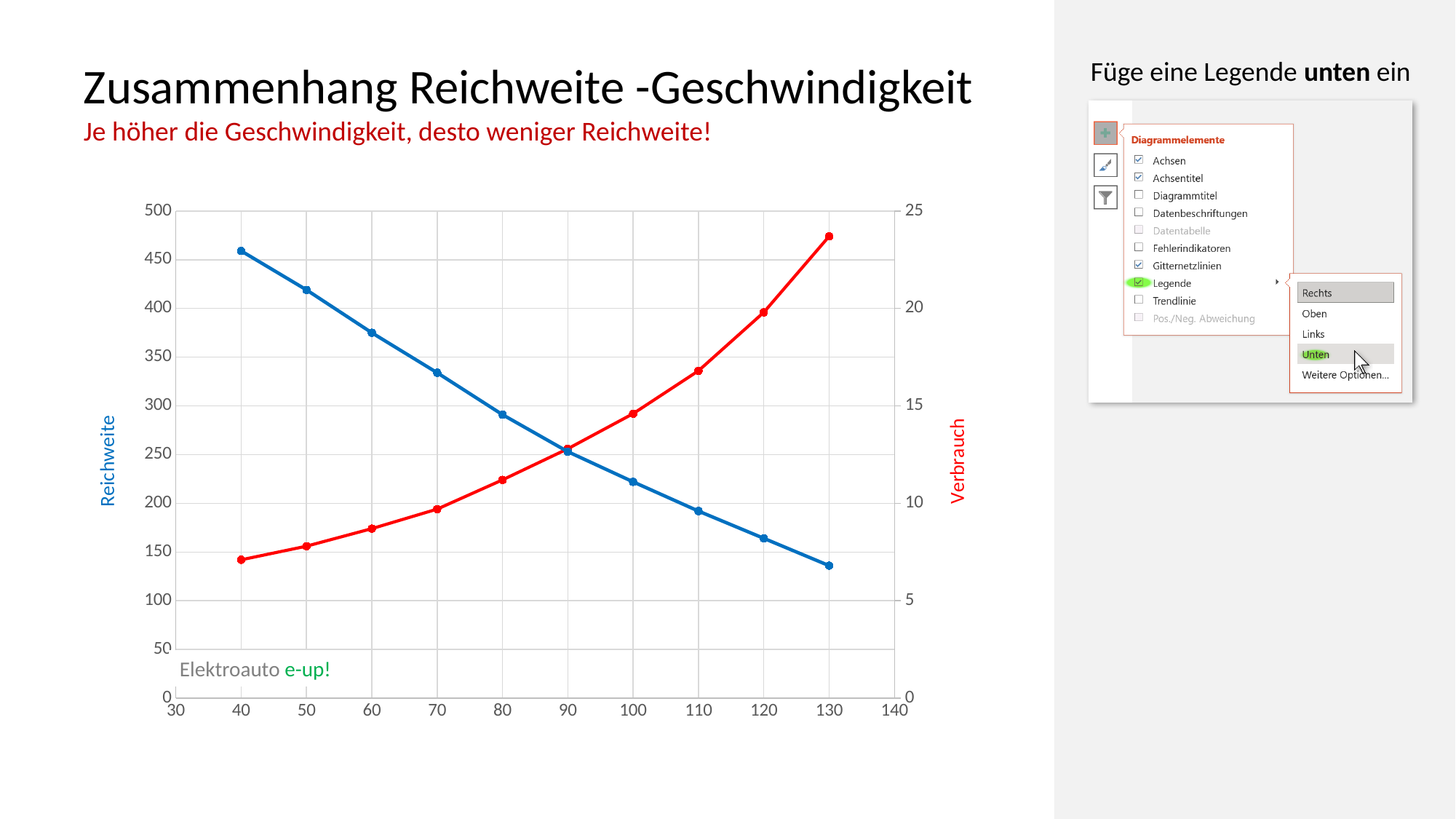
Does the Verbrauch line rise or fall as the x-axis value increases? rise Is the Reichweite value at x = 40 greater or less than 400? greater At which x-axis value is the Verbrauch line lowest? 40 Is the Reichweite value at x = 130 greater or less than 150? less Which is larger: the Reichweite value at x = 50 or at x = 100? x = 50 What is the title of the right-hand vertical axis? Verbrauch Does the Reichweite line rise or fall as the x-axis value increases? fall Is the Verbrauch value at x = 40 greater or less than 10? less What kind of chart is shown on the slide? line chart At which x-axis value is the Reichweite line highest? 40 How many data points does each line in the chart have? 10